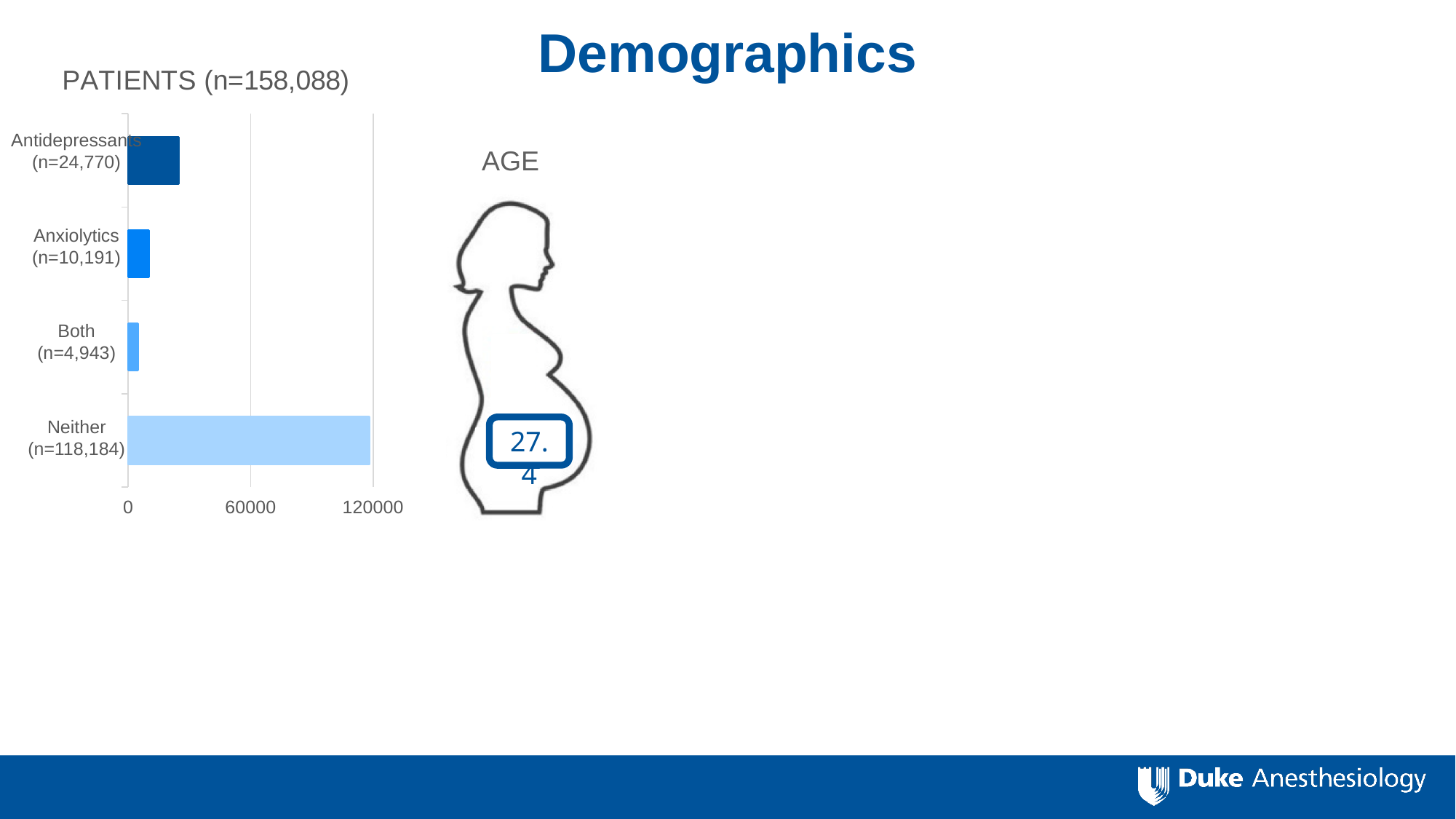
What is the title of the bar chart on the left of the slide? PATIENTS (n=158,088) In the PATIENTS (n=158,088) chart, how many patients are in the Both category? 4,943 In the PATIENTS (n=158,088) chart, how many patients are in the Neither category? 118,184 In the PATIENTS (n=158,088) chart, how many patients are in the Anxiolytics category? 10,191 What kind of chart is the PATIENTS (n=158,088) chart? bar chart In the PATIENTS (n=158,088) chart, is the value for Neither greater or less than 60000? greater In the PATIENTS (n=158,088) chart, which is larger: Antidepressants or Anxiolytics? Antidepressants Which category has the lowest value in the PATIENTS (n=158,088) chart? Both How many categories does the PATIENTS (n=158,088) bar chart show? 4 In the PATIENTS (n=158,088) chart, what is the difference between the Antidepressants and Anxiolytics values? 14,579 Which category has the highest value in the PATIENTS (n=158,088) chart? Neither In the PATIENTS (n=158,088) chart, how many patients are in the Antidepressants category? 24,770